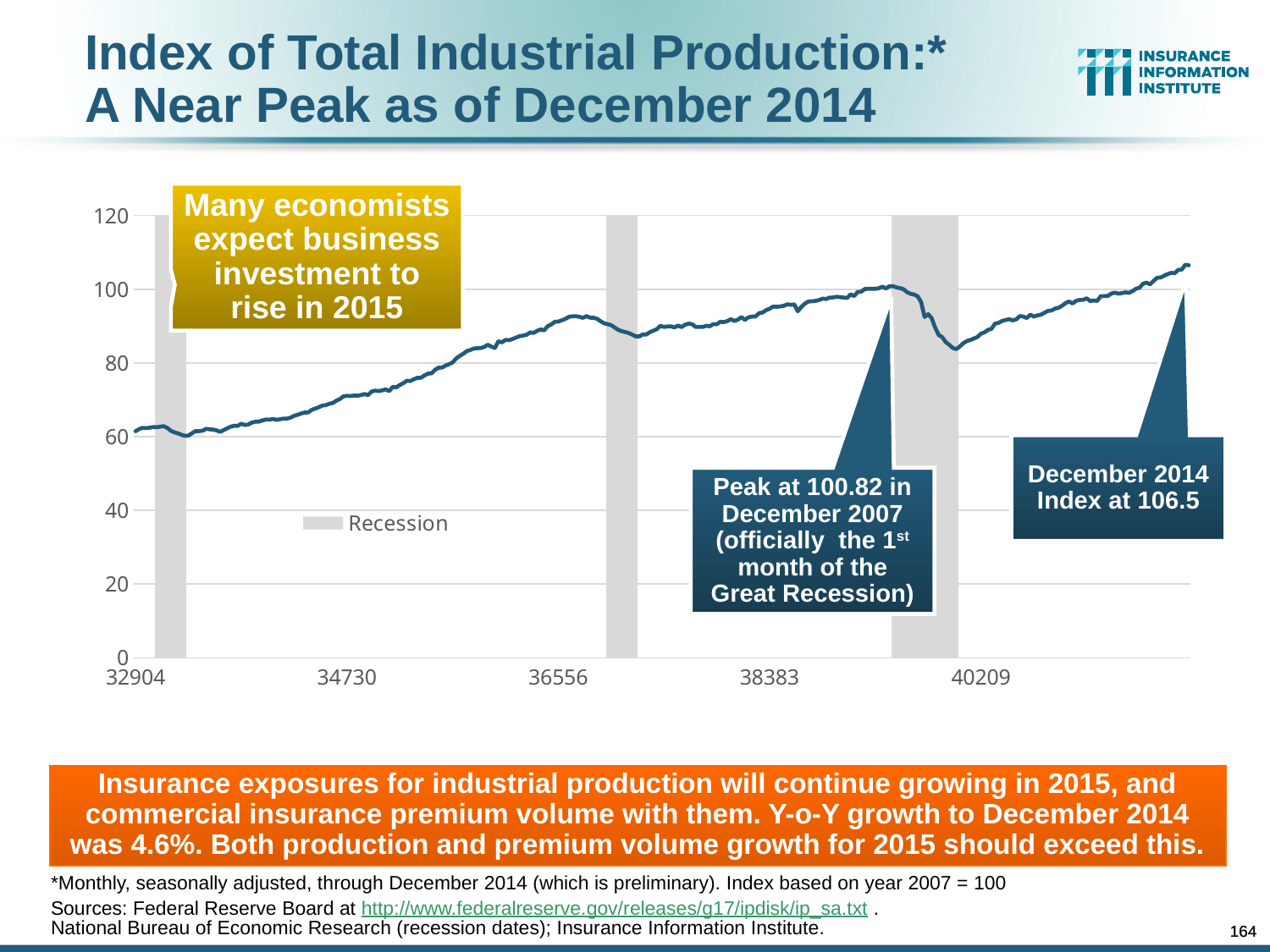
What kind of chart is shown on the slide? line chart By how much does the December 2014 index (106.5) exceed the December 2007 peak (100.82)? 5.68 What was the index value in December 2014? 106.5 Is the index value at x-axis label 40209 greater or less than 100? less Is the December 2014 index value greater or less than 100? greater What was the peak value of the index in December 2007? 100.82 Is the index value at the start of the series (x-axis label 32904) greater or less than 80? less Which is higher: the index in December 2014 or the peak in December 2007? December 2014 Overall, does the index rise or fall from the left of the chart to the right? rise What is the single entry shown in the chart's legend? Recession What do the gray shaded vertical bands on the chart represent? Recession